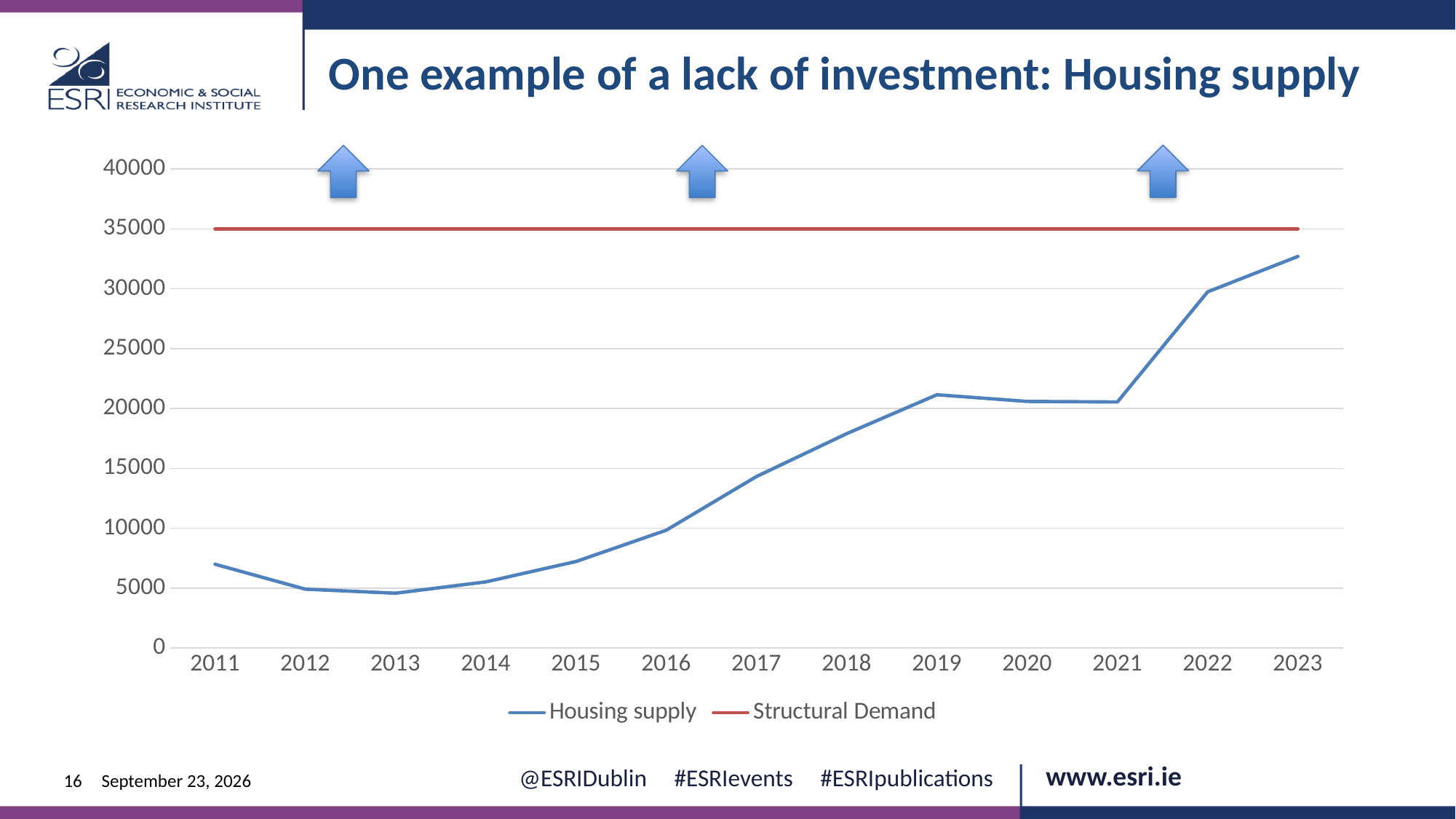
How many series does the legend list? 2 What is the value of the Structural Demand line? 35000 Which is larger in 2023: Housing supply or Structural Demand? Structural Demand Is the Housing supply value for 2023 greater or less than 30000? greater Is the Housing supply value for 2013 greater or less than 10000? less What kind of chart is shown on the slide? Line chart How many years are shown on the x axis? 13 Does Housing supply rise or fall between 2013 and 2019? Rise In which year is Housing supply highest? 2023 Is the Housing supply value for 2019 greater or less than 20000? greater In which year is Housing supply lowest? 2013 What is the title of the slide? One example of a lack of investment: Housing supply